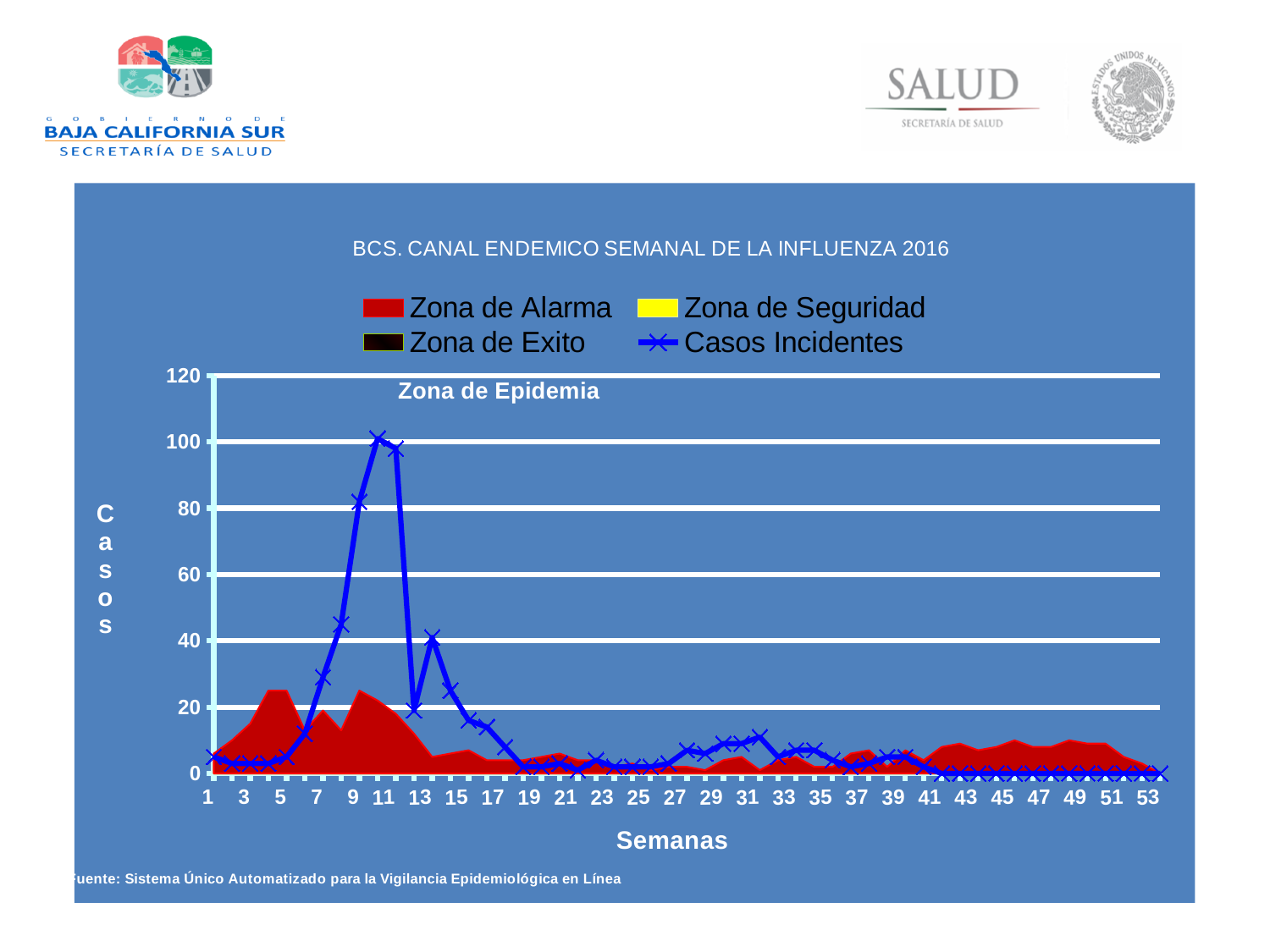
What is the title of the chart? BCS. CANAL ENDEMICO SEMANAL DE LA INFLUENZA 2016 How many series does the legend list? 4 Do the Casos Incidentes values rise or fall from week 11 to week 19? fall Is the value of Casos Incidentes at week 21 greater or less than 20? less What is the highest value shown on the y axis? 120 What kind of chart is used to show the Casos Incidentes series? Line chart Which is larger, the Casos Incidentes value at week 9 or at week 14? week 9 What is the last week number labelled on the x axis? 53 Is the value of Casos Incidentes at week 14 greater or less than 20? greater Is the value of Casos Incidentes at week 9 greater or less than 60? greater